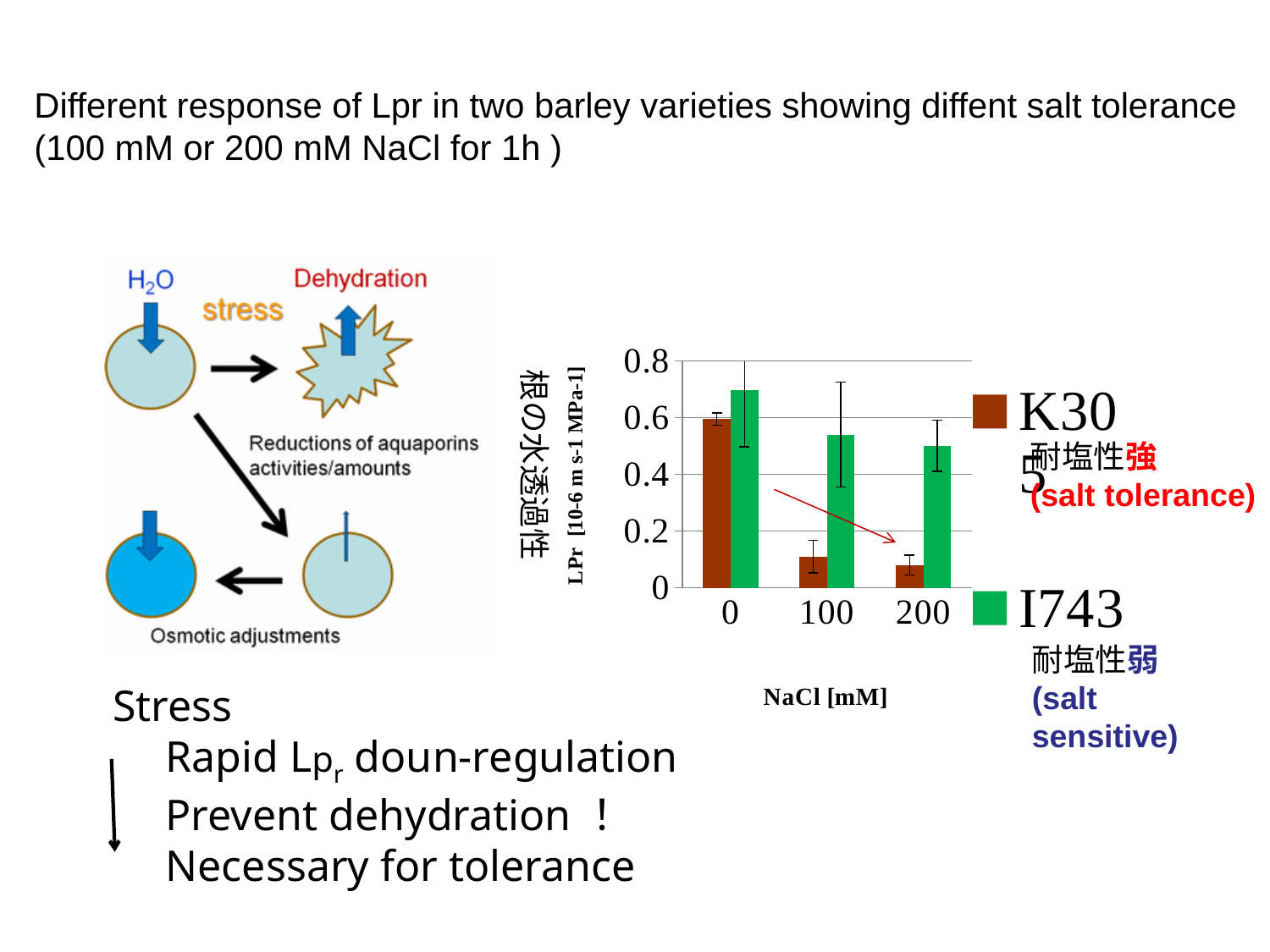
Which series in the chart is drawn in green? I743 Is the value for K30 at 100 mM NaCl greater or less than 0.2? less How many NaCl concentration categories are shown on the x axis of the chart? 3 What is the x-axis title of the chart? NaCl [mM] Is the value for I743 at 100 mM NaCl greater or less than 0.4? greater Is the value for K30 at 0 mM NaCl greater or less than 0.4? greater At 200 mM NaCl, which series has the larger value, K30 or I743? I743 Which series and NaCl concentration has the highest bar in the chart? I743 at 0 mM What kind of chart is shown on the slide? bar chart How many series does the chart legend list? 2 Do the K30 values rise or fall as NaCl concentration increases along the x axis? fall